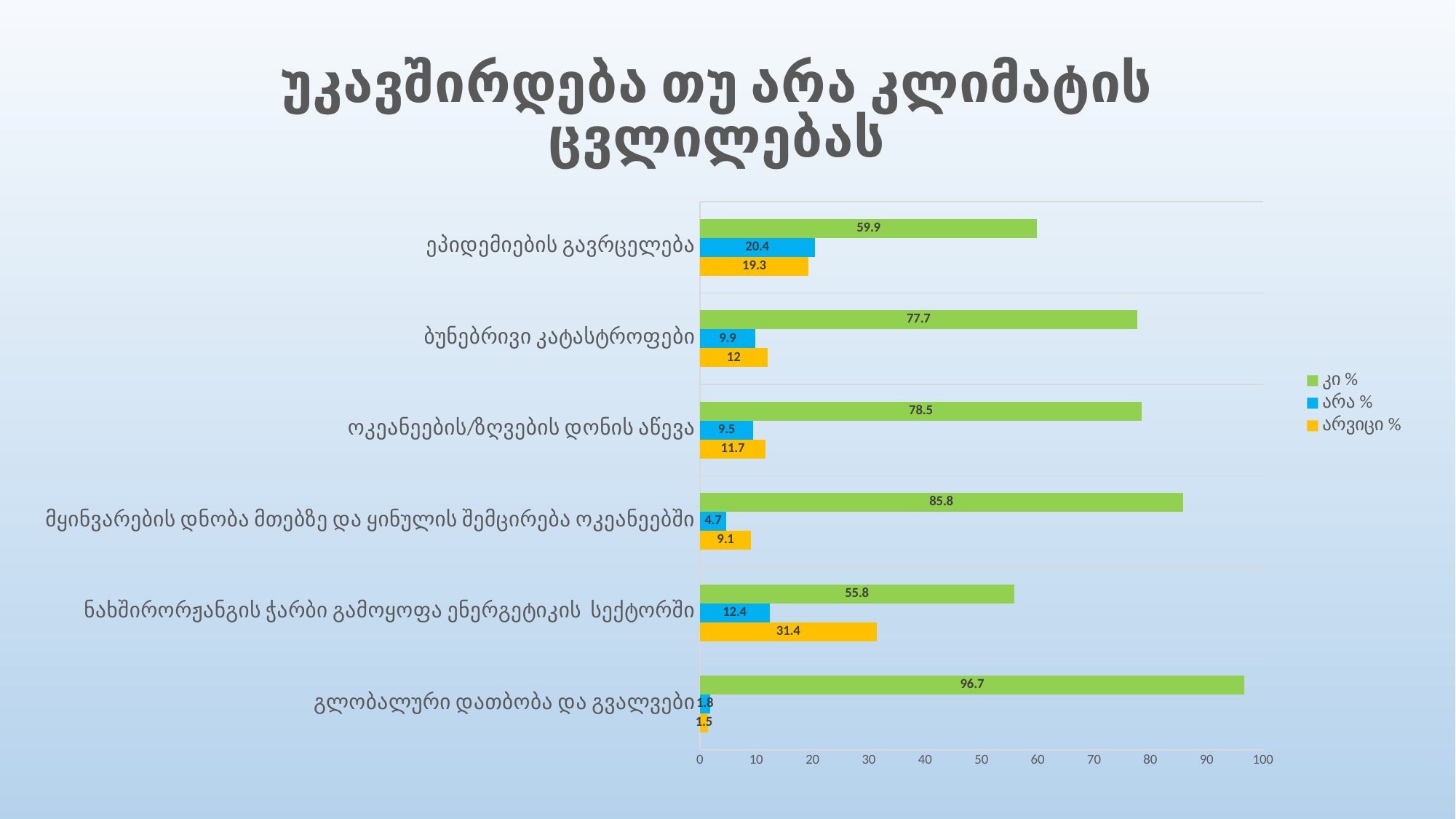
Which colour represents the "არვიცი %" series? yellow What type of chart is shown on the slide? bar chart What is the value of the "არა %" series for "ბუნებრივი კატასტროფები"? 9.9 What is the difference between the "კი %" and "არა %" values for "ეპიდემიების გავრცელება"? 39.5 Is the "კი %" value for "მყინვარების დნობა მთებზე და ყინულის შემცირება ოკეანეებში" greater or less than 80? greater What is the value of the "კი %" series for "ეპიდემიების გავრცელება"? 59.9 What is the value of the "არვიცი %" series for "ნახშირორჟანგის ჭარბი გამოყოფა ენერგეტიკის სექტორში"? 31.4 How many categories are shown on the chart? 6 For "ნახშირორჟანგის ჭარბი გამოყოფა ენერგეტიკის სექტორში", which is larger: the "არა %" value or the "არვიცი %" value? არვიცი % Which category has the highest "კი %" value? გლობალური დათბობა და გვალვები How many series does the legend list? 3 Which category has the lowest "კი %" value? ნახშირორჟანგის ჭარბი გამოყოფა ენერგეტიკის სექტორში